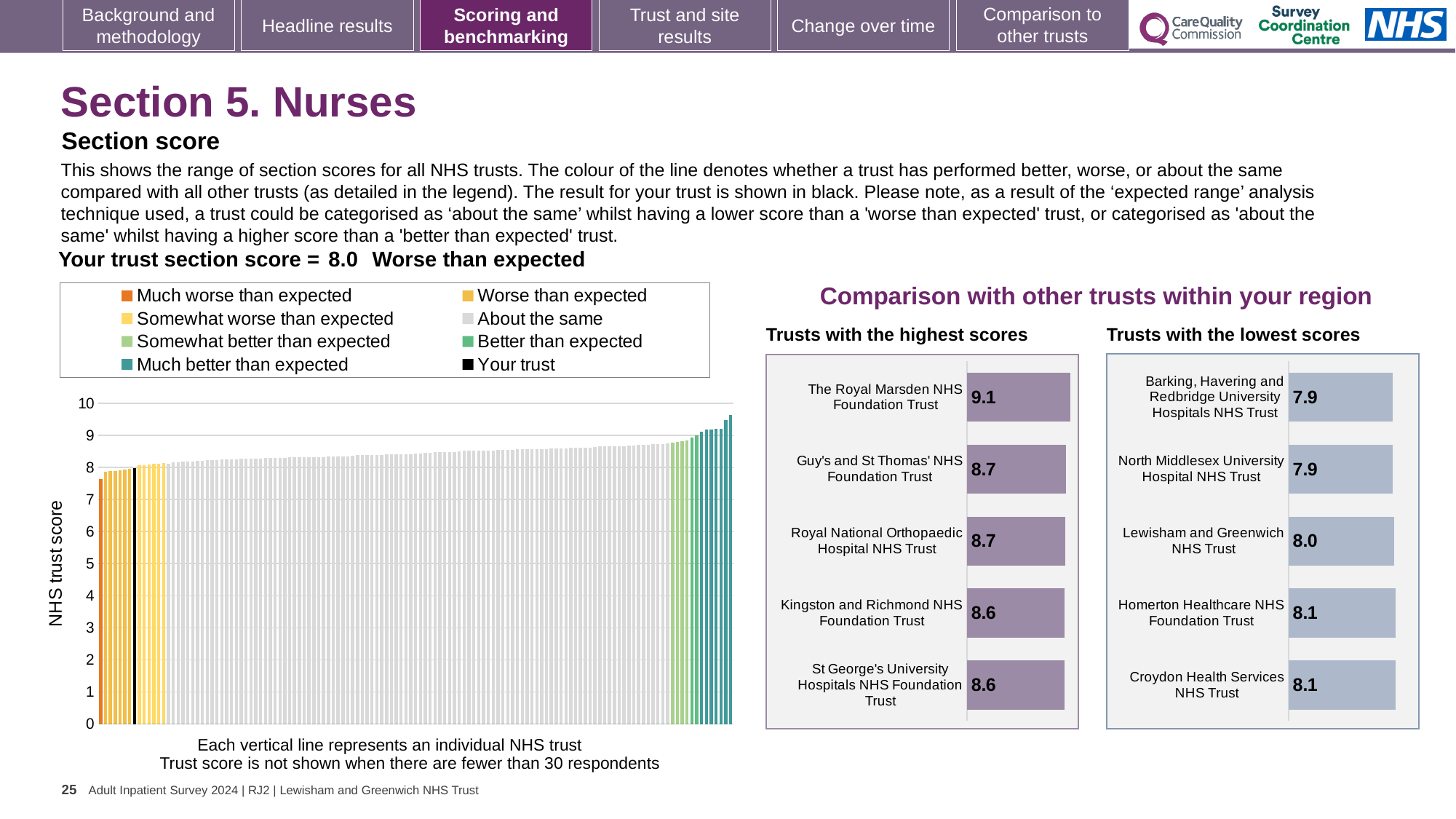
In the 'Trusts with the lowest scores' chart, what is the difference between the scores of Croydon Health Services NHS Trust and North Middlesex University Hospital NHS Trust? 0.2 How many trusts are shown in the 'Trusts with the lowest scores' chart? 5 In the 'Trusts with the lowest scores' chart, what is the score for Homerton Healthcare NHS Foundation Trust? 8.1 In the 'Trusts with the highest scores' chart, what is the score for The Royal Marsden NHS Foundation Trust? 9.1 How many entries does the legend of the large NHS trust score chart list? 8 What kind of chart is the large chart showing NHS trust scores on the left of the slide? Bar chart In the large NHS trust score chart, do the bar heights rise or fall from left to right along the x axis? Rise In the 'Trusts with the highest scores' chart, which has the larger score: Guy's and St Thomas' NHS Foundation Trust or St George's University Hospitals NHS Foundation Trust? Guy's and St Thomas' NHS Foundation Trust In the 'Trusts with the highest scores' chart, which trust has the highest score? The Royal Marsden NHS Foundation Trust In the large NHS trust score chart, is the value of the tallest bar on the far right greater or less than 9? greater In the 'Trusts with the highest scores' chart, what is the difference between the scores of The Royal Marsden NHS Foundation Trust and Kingston and Richmond NHS Foundation Trust? 0.5 In the 'Trusts with the lowest scores' chart, what is the score for Lewisham and Greenwich NHS Trust? 8.0